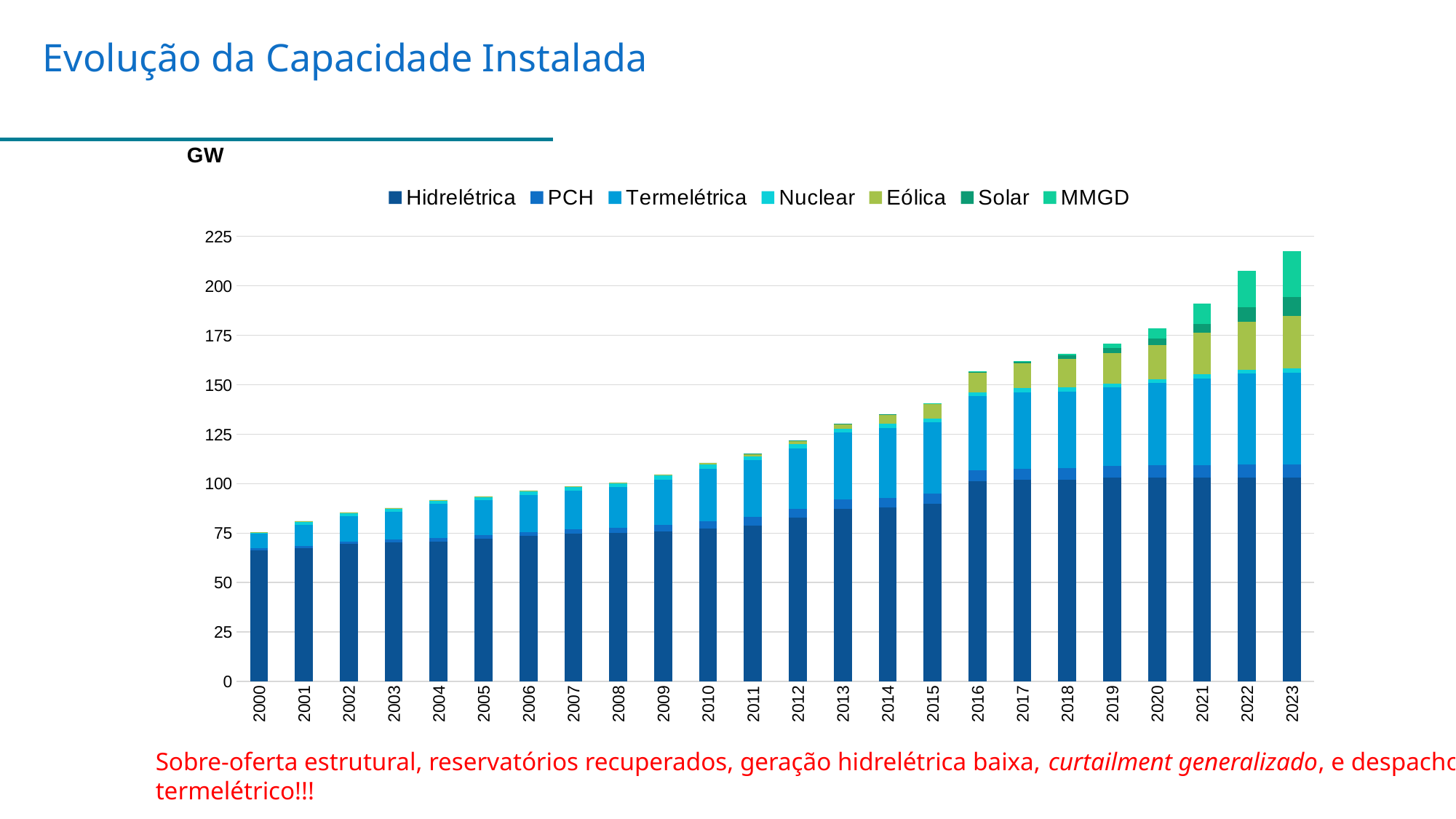
What kind of chart is shown on the slide? Stacked bar chart Is the total installed capacity for 2000 greater or less than 100? less How many series does the legend list? 7 What is the title of the chart on the slide? Evolução da Capacidade Instalada Which year has a larger total installed capacity, 2010 or 2022? 2022 Do the total bar heights rise or fall from 2000 to 2023? Rise Is the total installed capacity for 2016 greater or less than 150? greater What unit is indicated for the values on the chart? GW Which year has the highest total installed capacity? 2023 Which year has the lowest total installed capacity? 2000 How many years are shown along the x axis? 24 Is the total installed capacity for 2023 greater or less than 200? greater